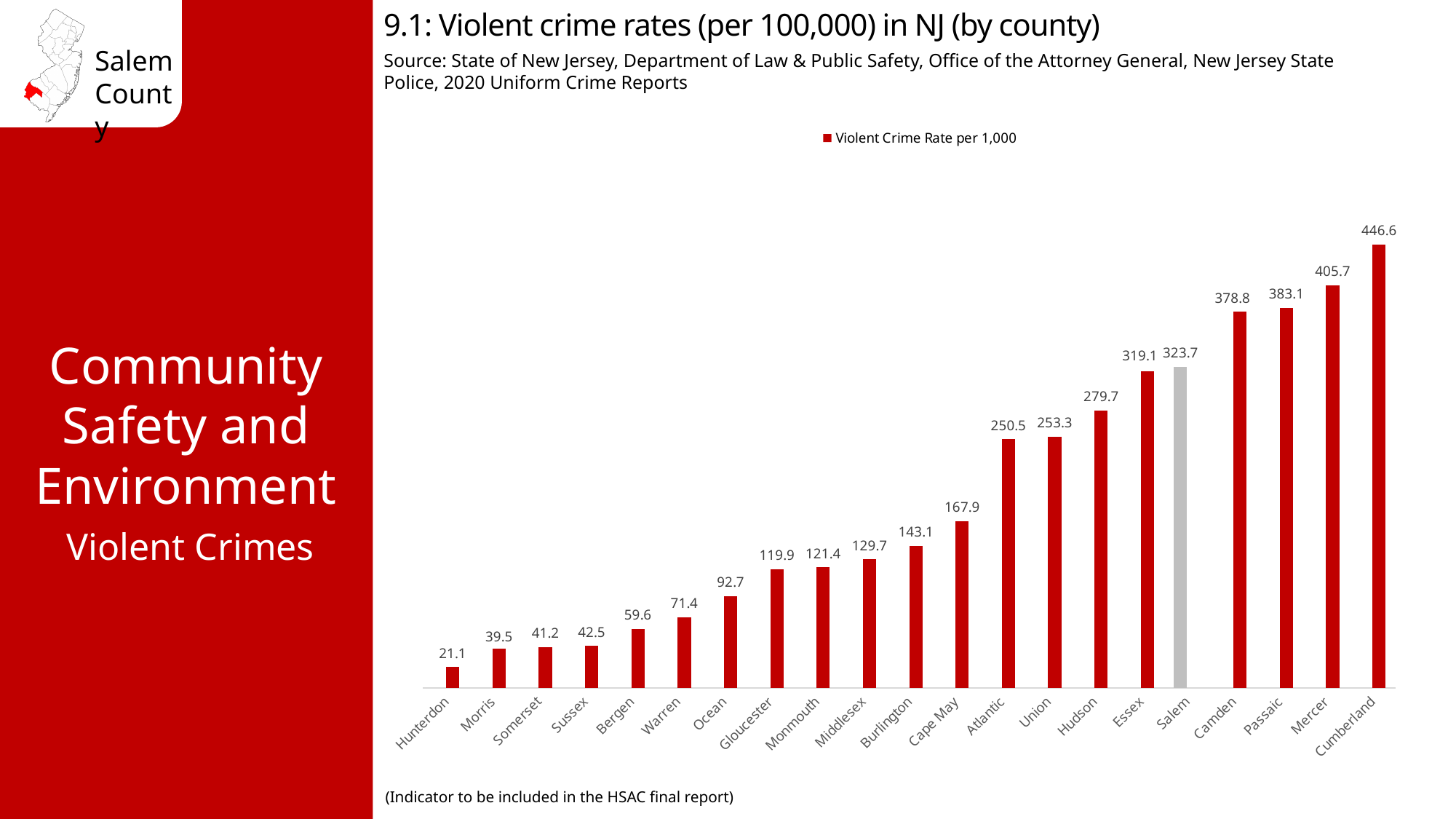
Which bar is coloured grey instead of red? Salem Which county has the highest violent crime rate on the chart? Cumberland Which county has the lowest violent crime rate on the chart? Hunterdon What is the difference between the values for Mercer and Camden? 26.9 How many series does the legend list? 1 What is the value shown for Hudson? 279.7 What kind of chart is shown on the slide? Bar chart What is the difference between the values for Cumberland and Hunterdon? 425.5 How many counties are shown on the chart? 21 What is the violent crime rate shown for Salem county? 323.7 Which has a higher value, Atlantic or Ocean? Atlantic What is the value shown for Cape May? 167.9